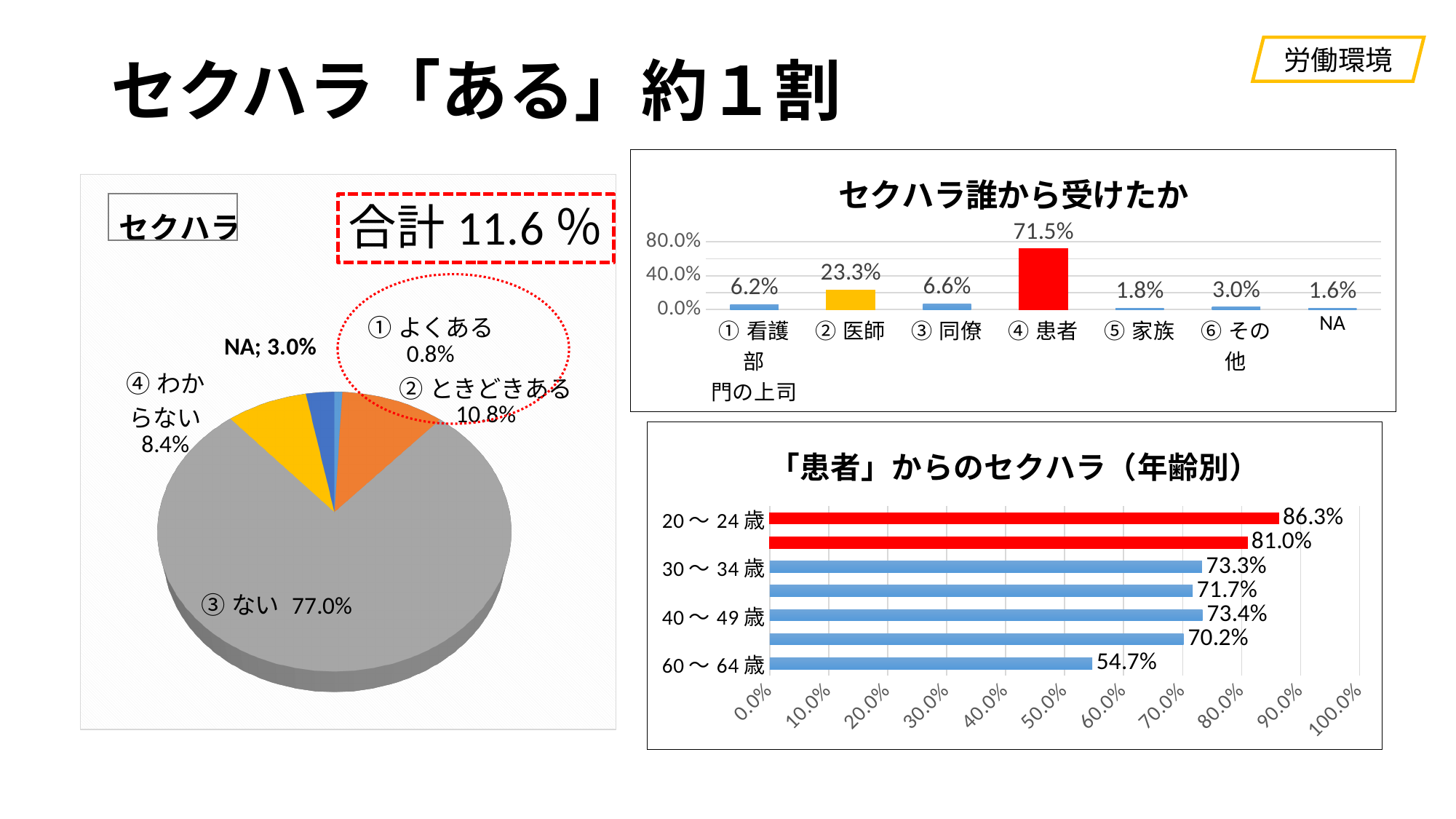
In the chart titled 「「患者」からのセクハラ（年齢別）」, what is the value for 60～64歳? 54.7% In the chart titled 「セクハラ誰から受けたか」, what is the difference between ④ 患者 and ② 医師? 48.2% In the chart titled 「セクハラ誰から受けたか」, what is the value for ④ 患者? 71.5% In the chart titled 「セクハラ誰から受けたか」, what is the value for ② 医師? 23.3% In the chart titled 「セクハラ誰から受けたか」, which category has the lowest value? NA In the pie chart titled 「セクハラ」, which slice is the smallest? ① よくある In the chart titled 「セクハラ誰から受けたか」, which is larger, ③ 同僚 or ⑥ その他? ③ 同僚 In the pie chart titled 「セクハラ」, what share does ③ ない have? 77.0% In the chart titled 「セクハラ誰から受けたか」, how many categories are shown on the x axis? 7 In the chart titled 「「患者」からのセクハラ（年齢別）」, what is the value for 20～24歳? 86.3% In the pie chart titled 「セクハラ」, what is the value for ② ときどきある? 10.8% What kind of chart is 「「患者」からのセクハラ（年齢別）」? bar chart